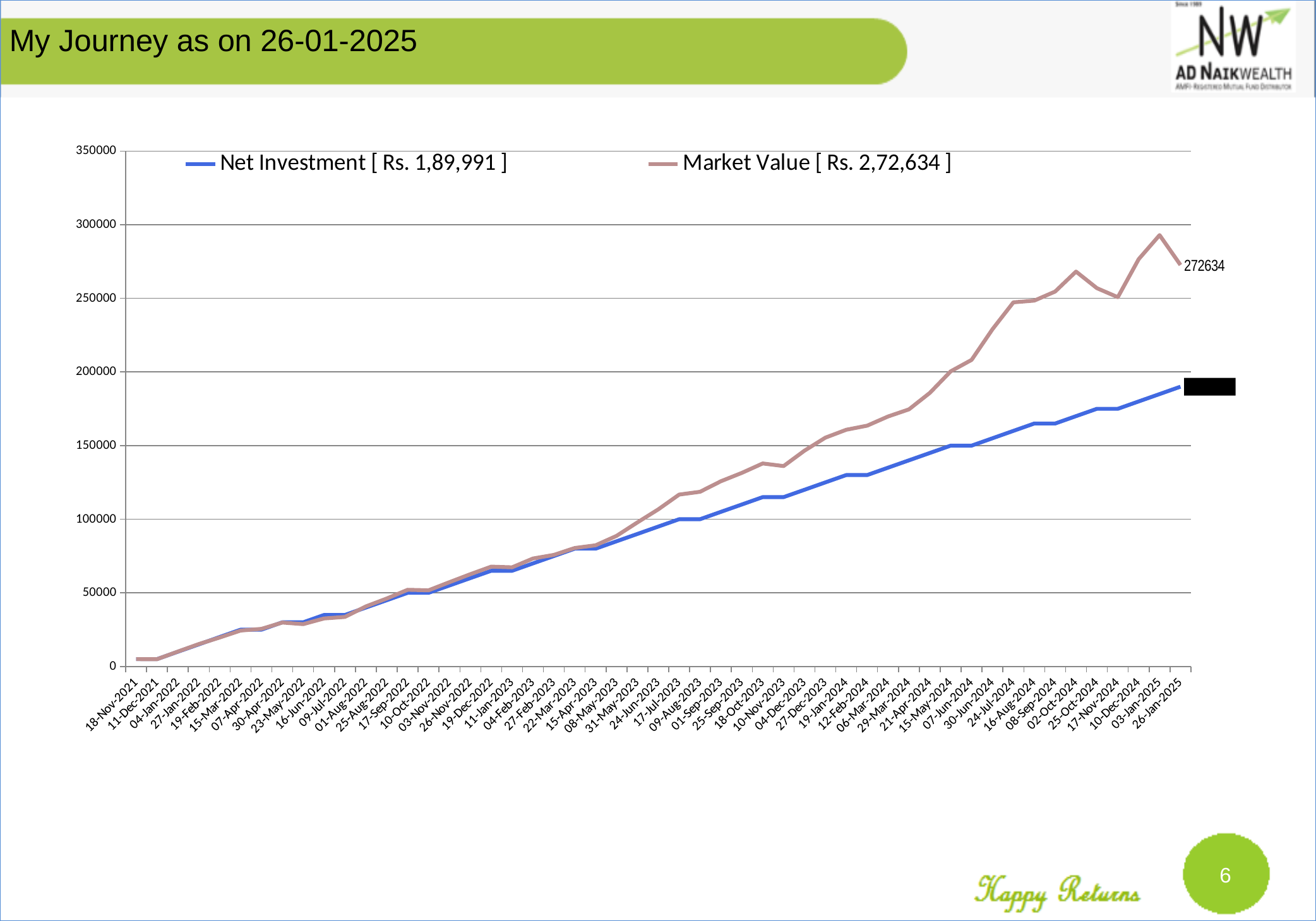
What kind of chart is shown on the slide? Line chart Is the Net Investment at 26-Jan-2025 greater or less than 200000? less What Net Investment amount is shown in the chart legend? Rs. 1,89,991 Does the Net Investment line generally rise or fall from 18-Nov-2021 to 26-Jan-2025? Rise What is the Market Value at 26-Jan-2025 according to the data label on the chart? 272634 What is the difference between the Market Value (Rs. 2,72,634) and the Net Investment (Rs. 1,89,991) shown in the legend? Rs. 82,643 Is the Market Value at 03-Jan-2025 greater or less than 250000? greater At 26-Jan-2025, which is larger: Market Value or Net Investment? Market Value How many series does the chart legend list? 2 At which date does the Market Value line reach its highest point? 03-Jan-2025 What colour is the Net Investment line on the chart? Blue What Market Value amount is shown in the chart legend? Rs. 2,72,634